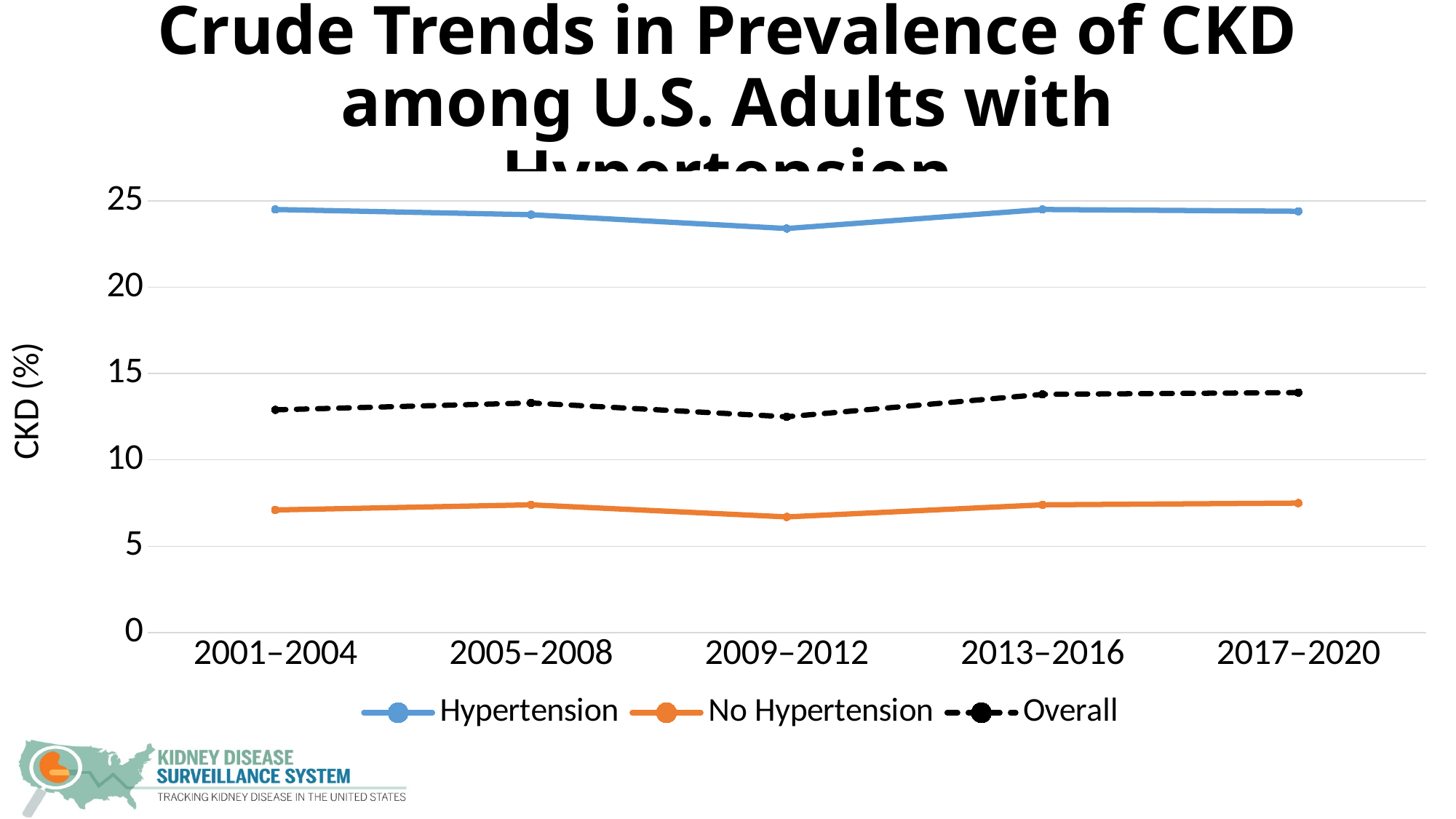
Is the value for Overall in 2017–2020 greater or less than 10? greater What kind of chart is shown on the slide? line chart Is the value for No Hypertension in 2013–2016 greater or less than 10? less How many time periods are shown on the x axis? 5 Which series has the highest CKD prevalence across all periods? Hypertension Is the value for Overall in 2009–2012 greater or less than 15? less How many series does the legend list? 3 What is the label of the y axis? CKD (%) Which series is drawn with a dashed line? Overall Which is larger in 2001–2004, the Hypertension value or the Overall value? Hypertension Which series has the lowest CKD prevalence across all periods? No Hypertension